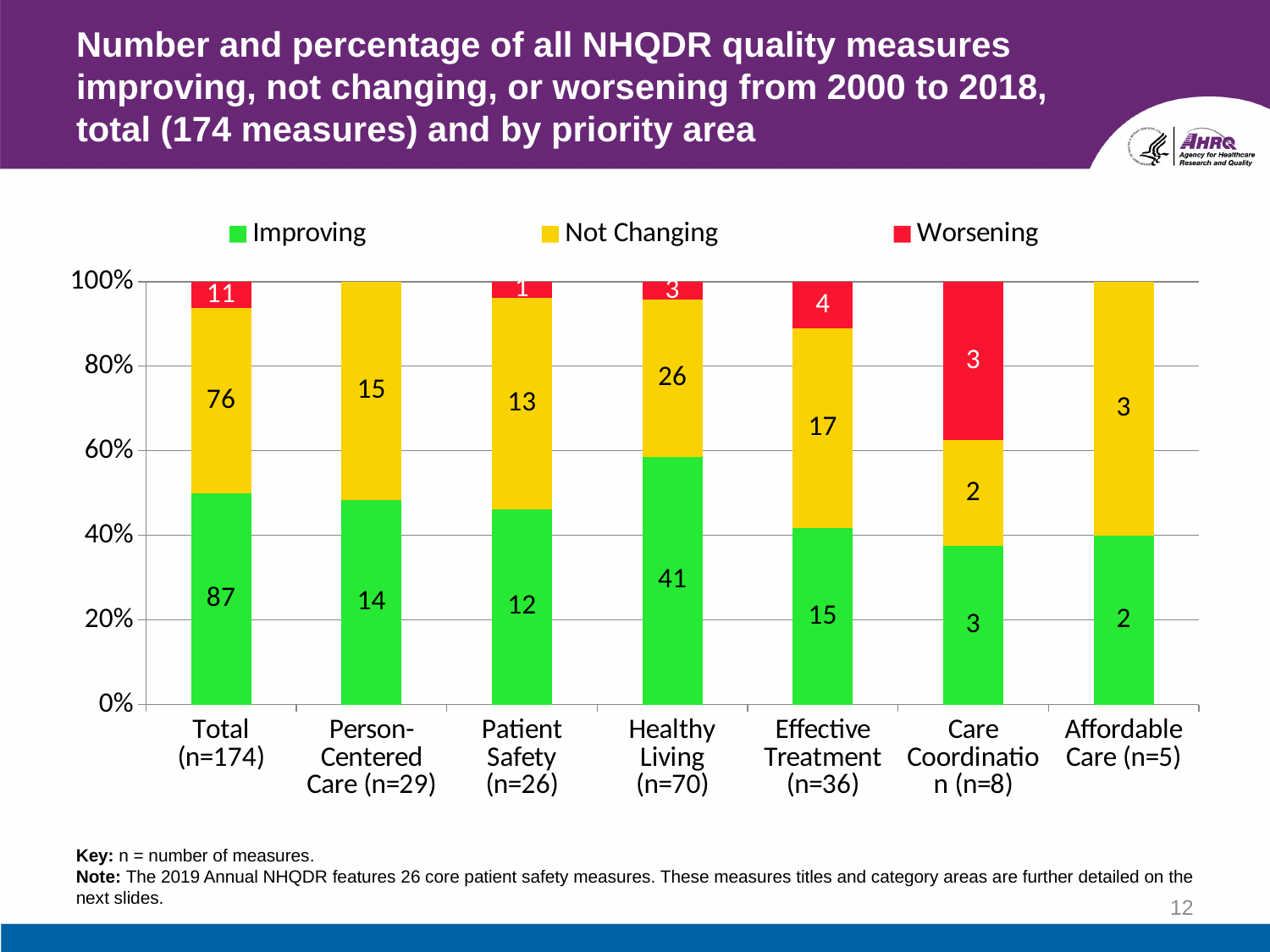
What is the sum of the labelled segments in the Patient Safety (n=26) bar? 26 What is the Worsening value for Effective Treatment (n=36)? 4 What is the Improving value for Care Coordination (n=8)? 3 What is the difference between the Not Changing and Worsening values for Total (n=174)? 65 Which bar has the largest Improving value? Total (n=174) How many categories are shown on the x axis? 7 What kind of chart is shown on the slide? Stacked bar chart For Healthy Living (n=70), which is larger: the Improving value or the Not Changing value? Improving What is the Not Changing value for Healthy Living (n=70)? 26 Is the Improving share of the Healthy Living (n=70) bar greater or less than 40%? greater How many Improving measures are shown for Total (n=174)? 87 How many series does the legend list? 3